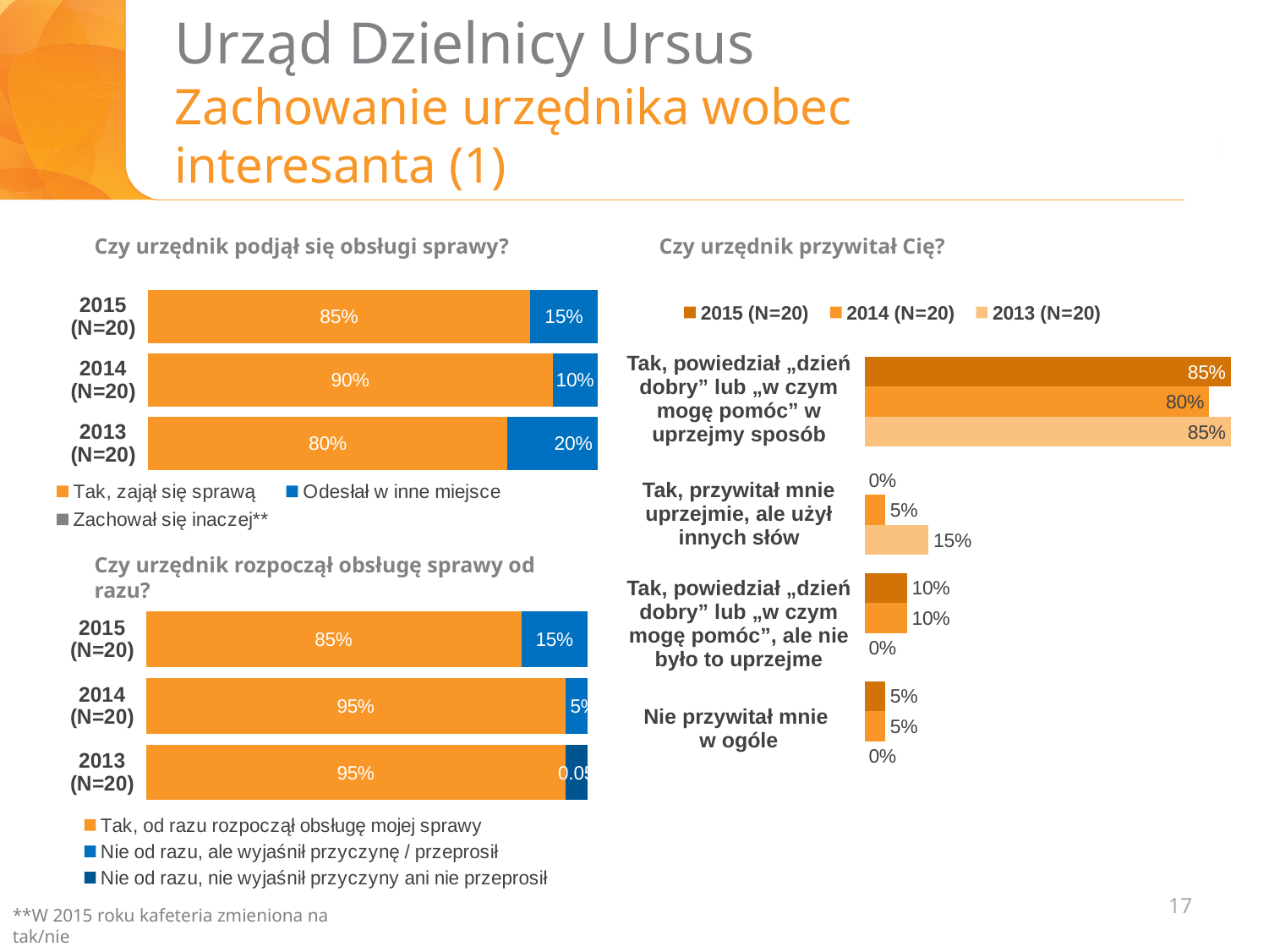
In the chart "Czy urzędnik rozpoczął obsługę sprawy od razu?", what percentage for 2015 (N=20) is labelled "Tak, od razu rozpoczął obsługę mojej sprawy"? 85% In the chart "Czy urzędnik podjął się obsługi sprawy?", which year has the highest share for "Tak, zajął się sprawą"? 2014 (N=20) How many categories are shown in the chart "Czy urzędnik przywitał Cię?"? 4 In the chart "Czy urzędnik podjął się obsługi sprawy?", what is the difference between the "Tak, zajął się sprawą" shares for 2014 and 2013? 10% What type of chart is "Czy urzędnik przywitał Cię?"? Bar chart How many legend entries does the chart "Czy urzędnik rozpoczął obsługę sprawy od razu?" list? 3 In the chart "Czy urzędnik przywitał Cię?", what is the 2013 (N=20) value for "Tak, przywitał mnie uprzejmie, ale użył innych słów"? 15% In the chart "Czy urzędnik przywitał Cię?", what is the 2014 (N=20) value for "Tak, powiedział „dzień dobry” lub „w czym mogę pomóc” w uprzejmy sposób"? 80% In the chart "Czy urzędnik przywitał Cię?", which is larger for "Nie przywitał mnie w ogóle": the 2015 value or the 2013 value? 2015 In the chart "Czy urzędnik podjął się obsługi sprawy?", what percentage for 2013 (N=20) is labelled "Odesłał w inne miejsce"? 20% In the chart "Czy urzędnik rozpoczął obsługę sprawy od razu?", which year has the lowest share for "Tak, od razu rozpoczął obsługę mojej sprawy"? 2015 (N=20) In the chart "Czy urzędnik podjął się obsługi sprawy?", what percentage for 2014 (N=20) is labelled "Tak, zajął się sprawą"? 90%